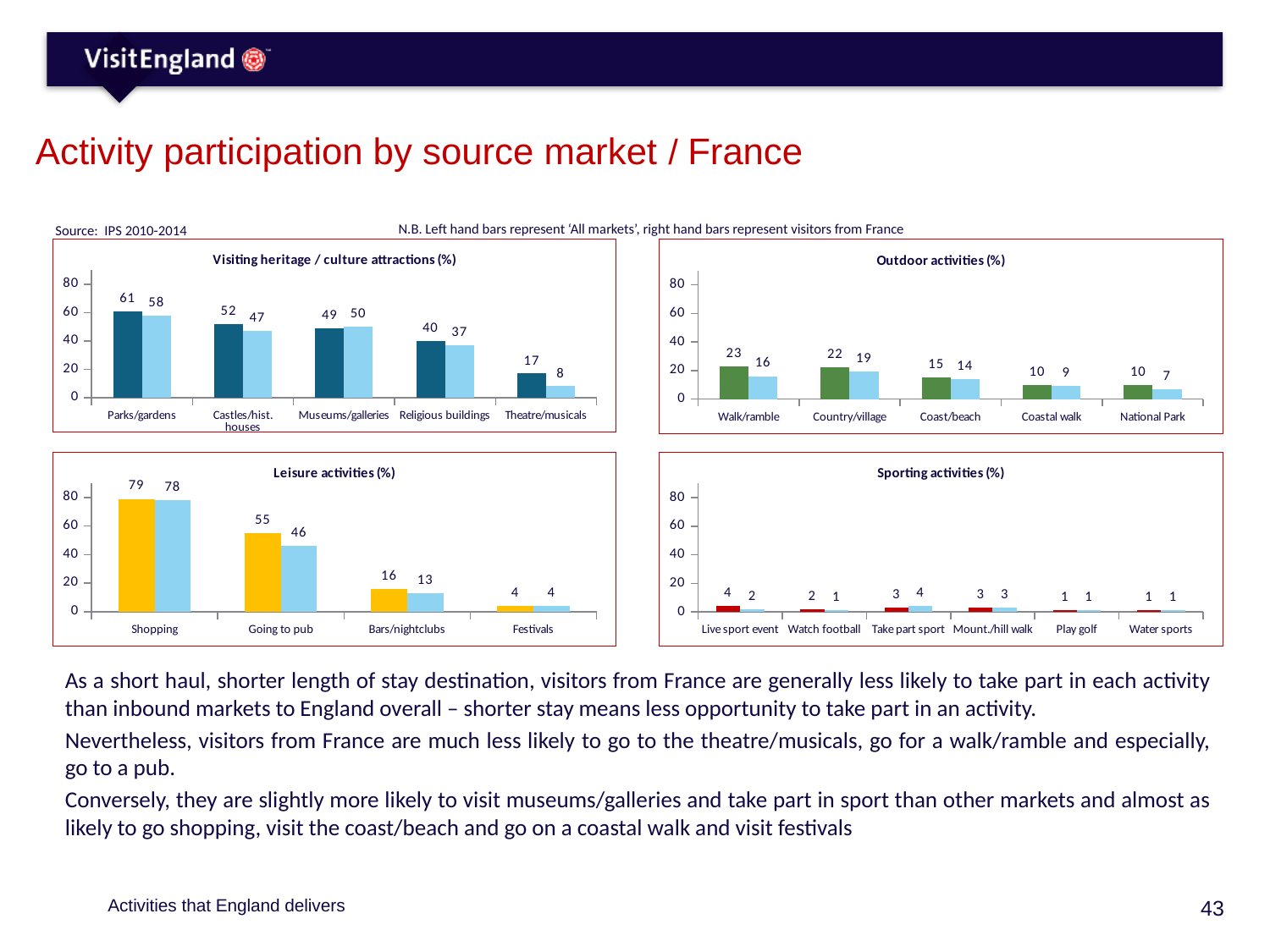
In the 'Leisure activities (%)' chart, which category has the lowest values? Festivals In the 'Sporting activities (%)' chart, what is the France (right-hand) value for Take part sport? 4 In the 'Leisure activities (%)' chart, what is the France (right-hand) value for Going to pub? 46 In the 'Visiting heritage / culture attractions (%)' chart, what is the value of the left-hand (All markets) bar for Theatre/musicals? 17 What type of chart is the 'Outdoor activities (%)' chart? bar chart In the 'Leisure activities (%)' chart, is the All markets bar for Shopping larger or smaller than the All markets bar for Going to pub? larger In the 'Visiting heritage / culture attractions (%)' chart, what is the difference between the All markets and France bars for Theatre/musicals? 9 In the 'Visiting heritage / culture attractions (%)' chart, what is the value of the right-hand (France) bar for Parks/gardens? 58 In the 'Sporting activities (%)' chart, how many categories are shown on the x axis? 6 In the 'Leisure activities (%)' chart, how many categories are shown on the x axis? 4 In the 'Outdoor activities (%)' chart, what is the France (right-hand) value for National Park? 7 In the 'Outdoor activities (%)' chart, which category has the highest All markets (left-hand) bar? Walk/ramble